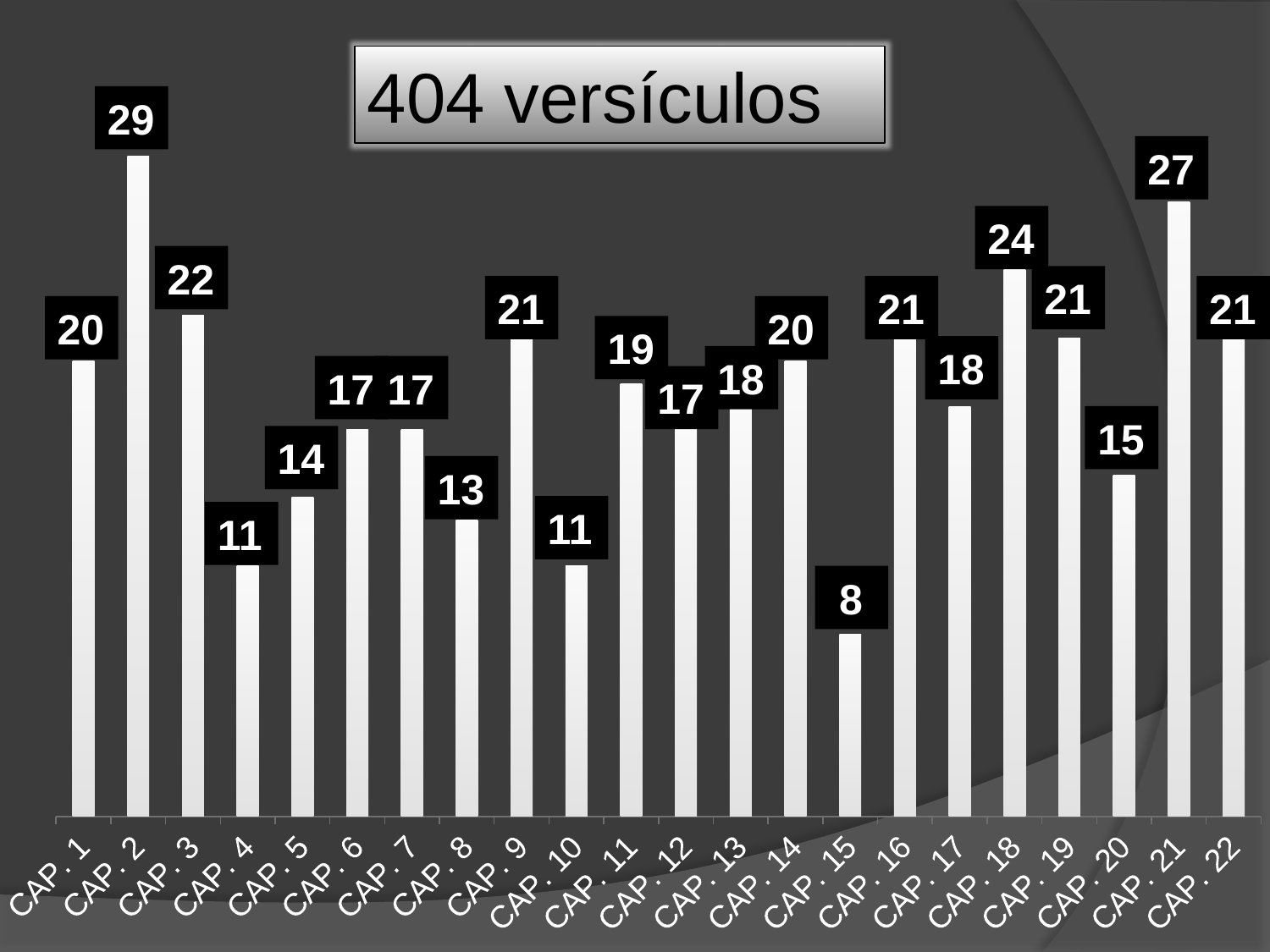
Which category has the highest value? CAP. 2 Which category has the lowest value? CAP. 15 How many categories are shown on the x axis? 22 Which is larger, the value for CAP. 3 or the value for CAP. 20? CAP. 3 What is the value for CAP. 2? 29 What is the difference between the values for CAP. 2 and CAP. 21? 2 What is the value for CAP. 15? 8 What is the value for CAP. 18? 24 What kind of chart is shown on the slide? Bar chart What is the title shown on the slide? 404 versículos What is the value for CAP. 9? 21 What is the difference between the values for CAP. 18 and CAP. 4? 13